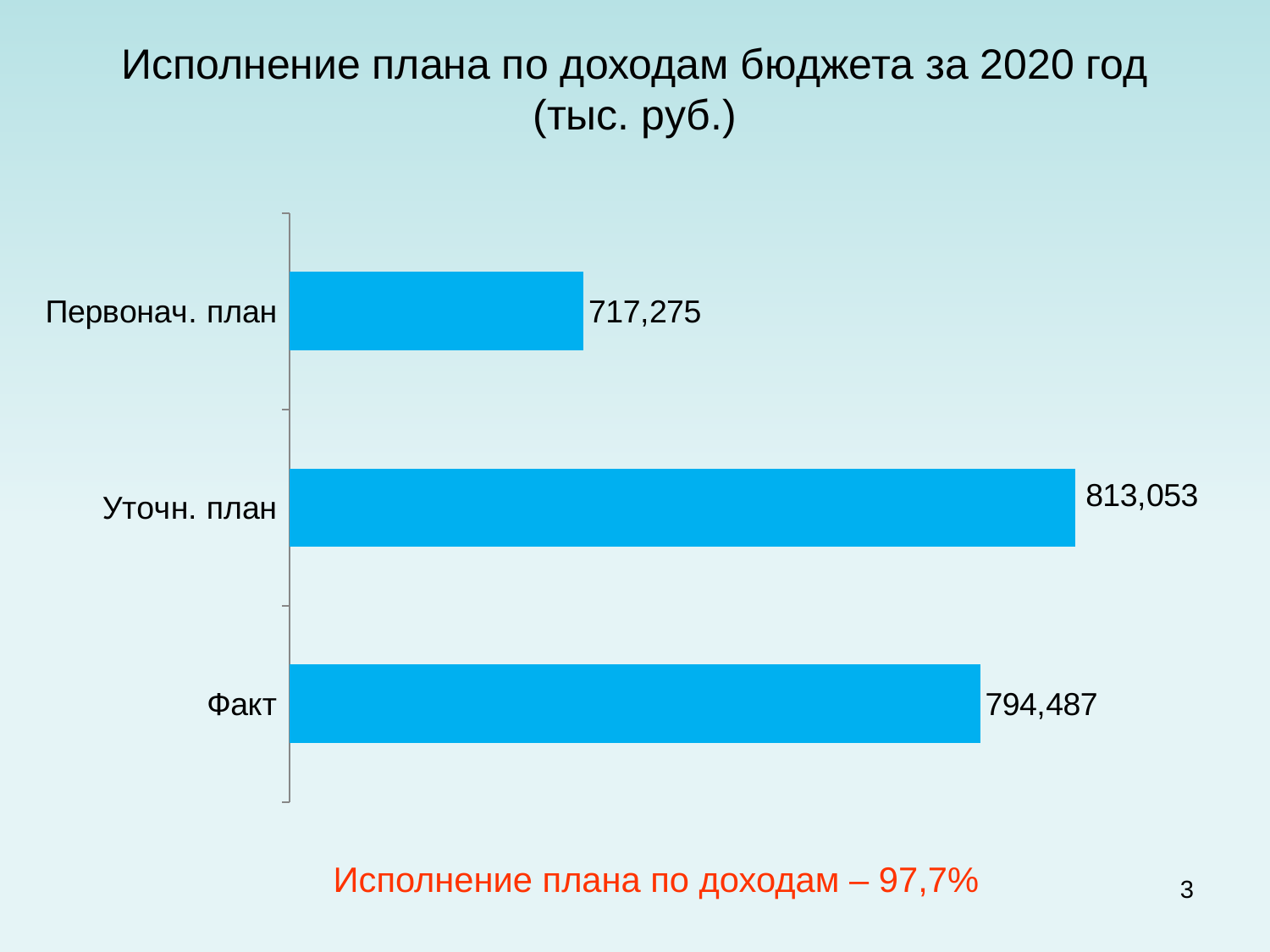
What is the value for Факт? 794,487 What is the value for Уточн. план? 813,053 Which category has the highest value? Уточн. план What is the difference between Уточн. план and Первонач. план? 95,778 What kind of chart is shown on the slide? Bar chart How many categories are shown in the chart? 3 Which category has the lowest value? Первонач. план What is the difference between Факт and Первонач. план? 77,212 Which is larger, Факт or Первонач. план? Факт What is the value for Первонач. план? 717,275 What is the title of the chart on the slide? Исполнение плана по доходам бюджета за 2020 год (тыс. руб.) What is the difference between Уточн. план and Факт? 18,566